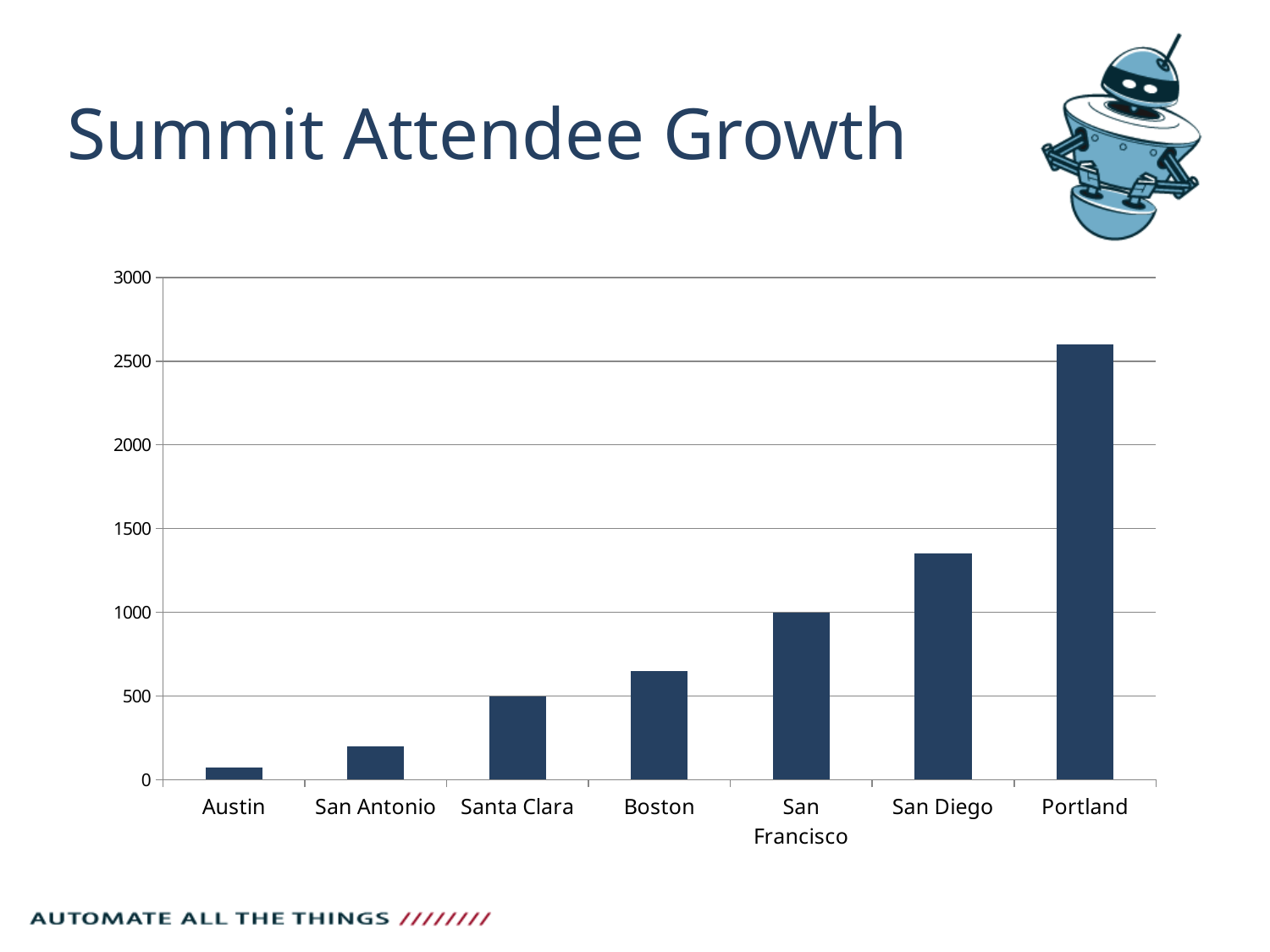
Is the value for Boston greater or less than 500? greater Is the value for Portland greater or less than 2500? greater Is the value for Austin greater or less than 500? less Which is larger, the value for San Diego or the value for Boston? San Diego What is the title of the slide containing the chart? Summit Attendee Growth Which city has the lowest bar in the chart? Austin How many cities are shown on the x axis of the chart? 7 Do the values rise or fall moving from Austin to Portland along the x axis? rise Which city has the highest bar in the chart? Portland What kind of chart is shown on the slide? bar chart